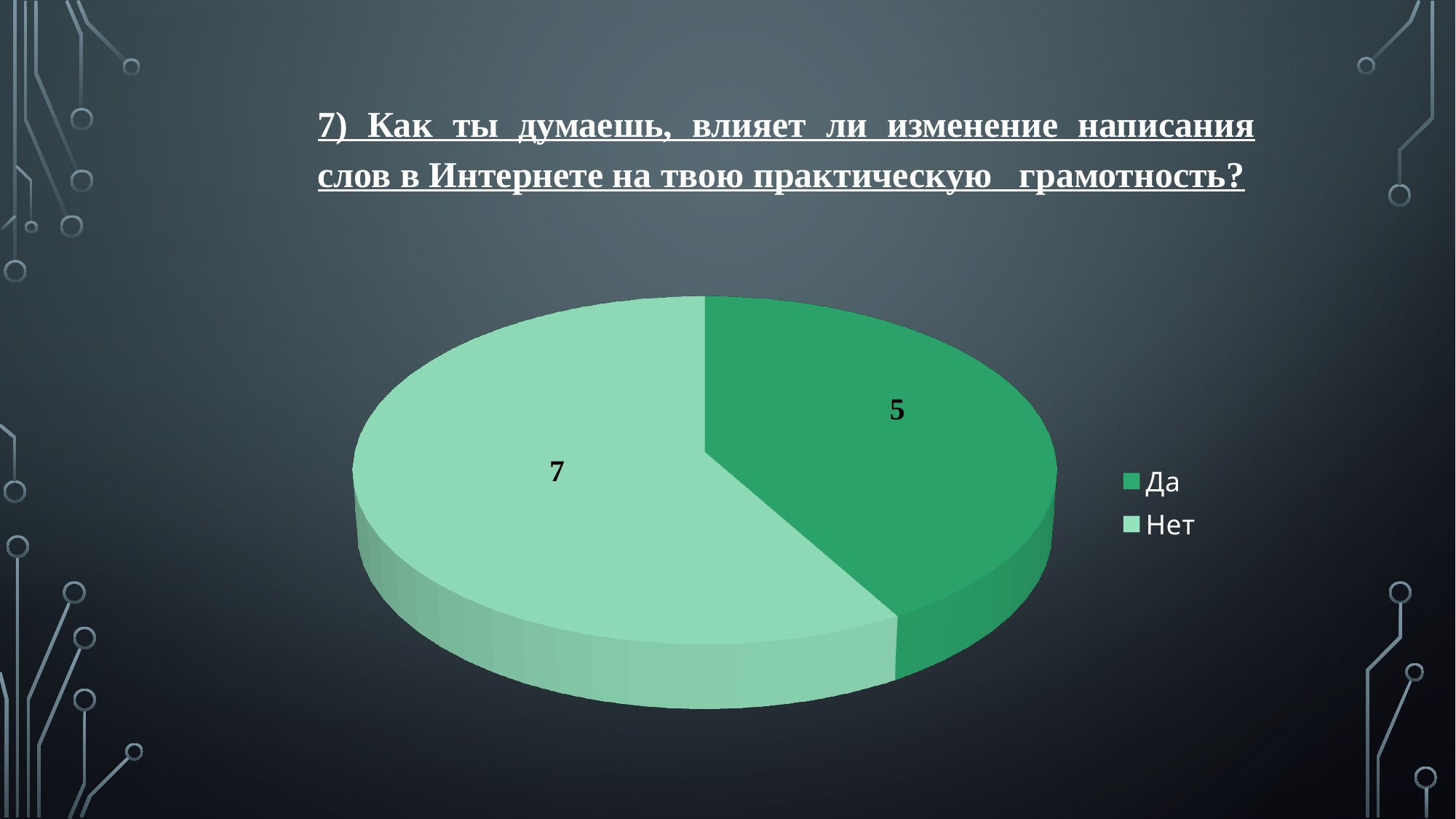
What is the value for "Да"? 5 Which category has the smallest slice? Да What type of chart is shown on the slide? pie chart What is the value for "Нет"? 7 Where is the legend positioned relative to the pie? to the right What is the total of all slices in the pie chart? 12 Which category has the largest slice? Нет Which is larger, the value for "Да" or the value for "Нет"? Нет How many entries does the legend list? 2 What is the difference between the values for "Нет" and "Да"? 2 How many slices does the pie chart have? 2 What colour is the "Да" slice? dark green